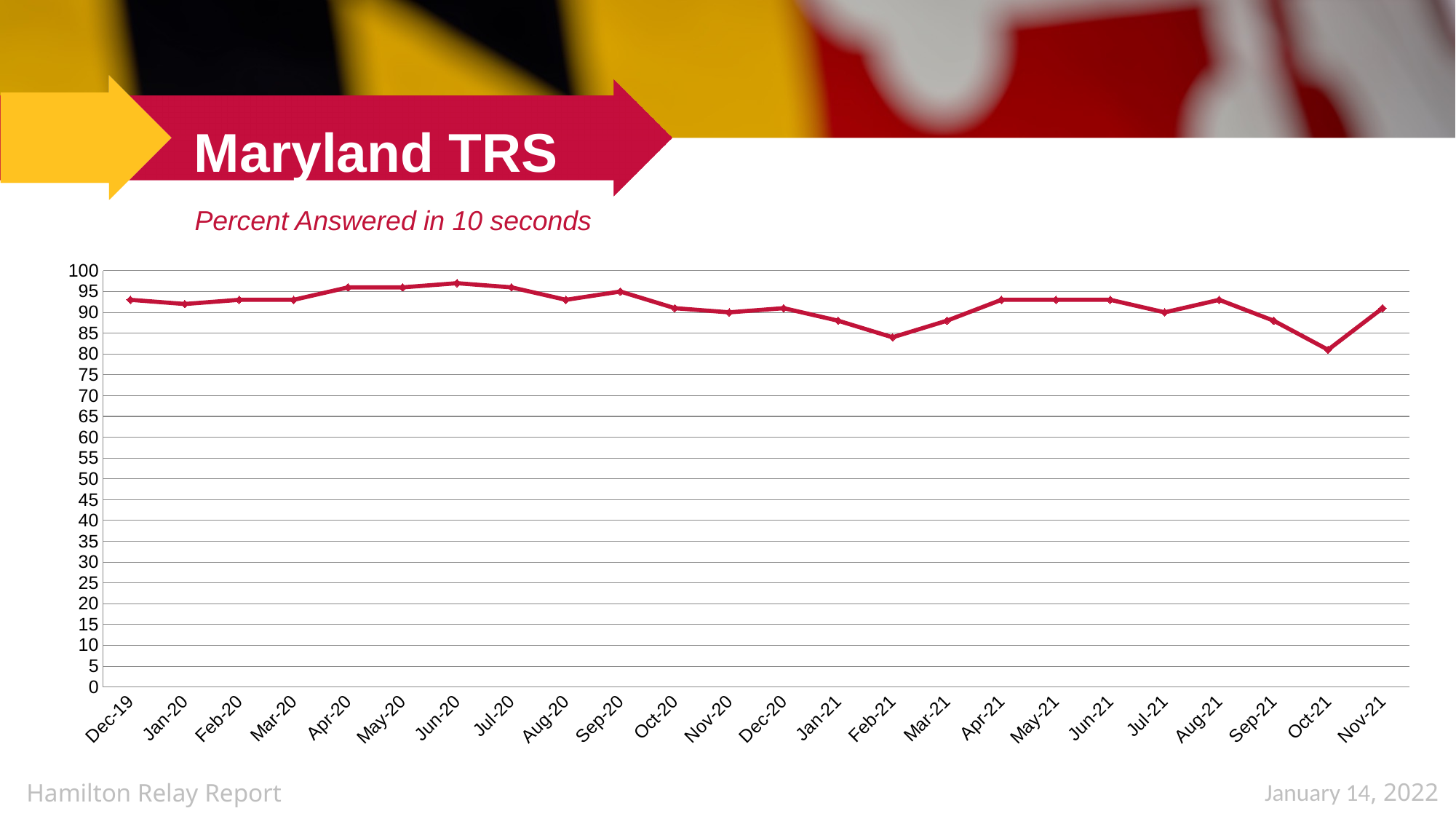
What kind of chart is shown on the slide? line chart Does the line rise or fall from Aug-21 to Oct-21? fall How many monthly data points are plotted on the chart? 24 Which is larger, the value for Jun-20 or the value for Oct-21? Jun-20 What is the title of the chart? Percent Answered in 10 seconds Which month has the lowest percent answered in 10 seconds? Oct-21 Is the value for Jun-20 greater or less than 95? greater Is the value for Dec-19 greater or less than 90? greater Which is larger, the value for Feb-21 or the value for Apr-21? Apr-21 Is the value for Oct-21 greater or less than 85? less Which month has the highest percent answered in 10 seconds? Jun-20